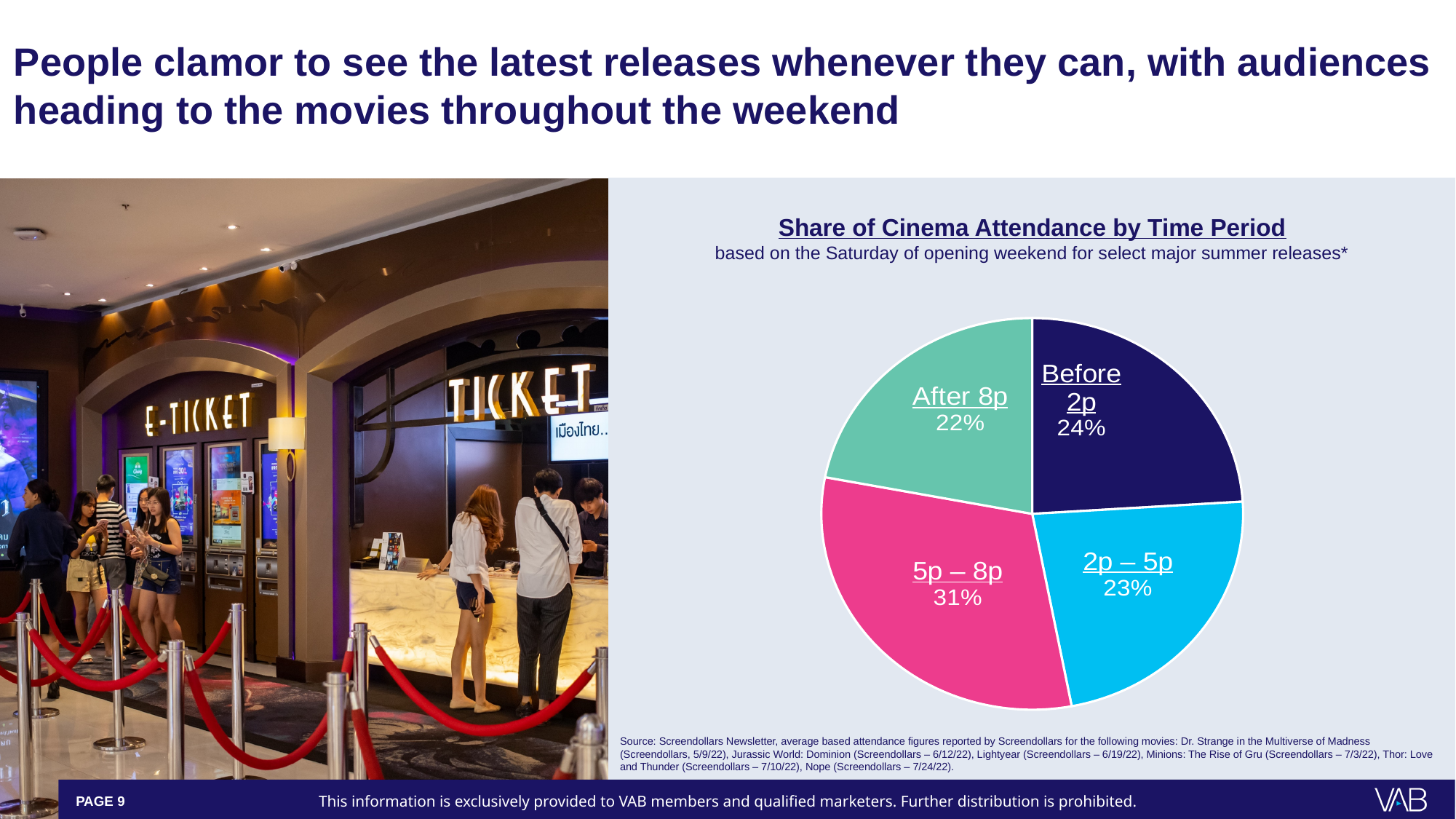
What share of cinema attendance is in the After 8p time period? 22% What is the title of the chart? Share of Cinema Attendance by Time Period What colour is the slice for the 5p – 8p time period? Pink How many time periods are shown in the pie chart? 4 What share of cinema attendance is in the 2p – 5p time period? 23% Which time period has the largest share of cinema attendance? 5p – 8p Which time period has the smallest share of cinema attendance? After 8p What share of cinema attendance is in the 5p – 8p time period? 31% What is the difference in share between the 5p – 8p and After 8p time periods? 9 percentage points What share of cinema attendance is in the Before 2p time period? 24% Which has a larger share of attendance, Before 2p or 2p – 5p? Before 2p What type of chart is used to show the share of cinema attendance by time period? Pie chart